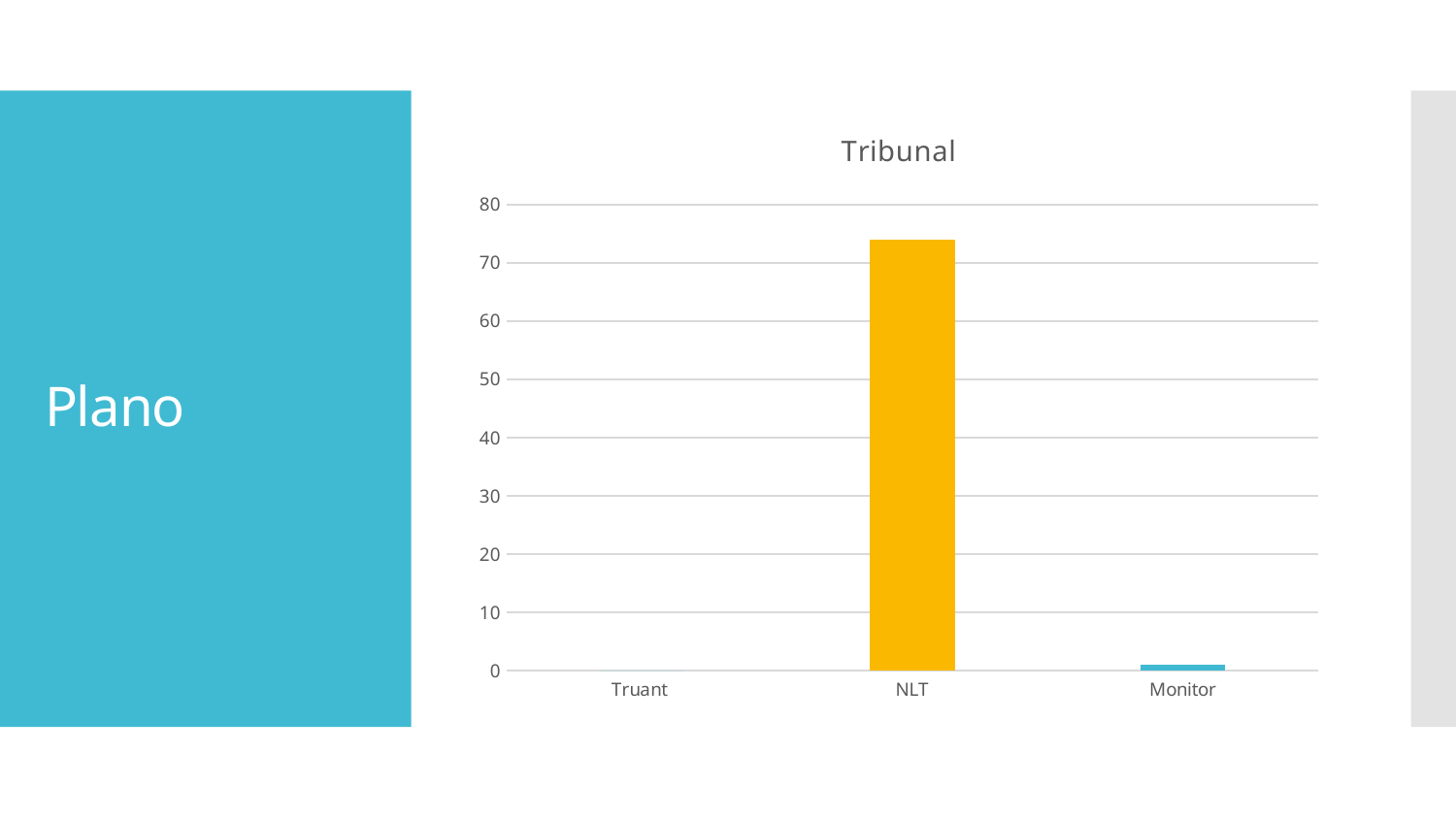
Which is larger, the value for NLT or the value for Monitor? NLT Is the value for NLT greater or less than 70? greater Is the value for Truant greater or less than 10? less How many categories are shown on the x axis of the chart? 3 Is the value for Monitor greater or less than 10? less What kind of chart is shown on the slide? bar chart What is the title of the chart? Tribunal Which category has the lowest value in the chart? Truant Which category has the highest value in the chart? NLT What colour is the bar for NLT? yellow